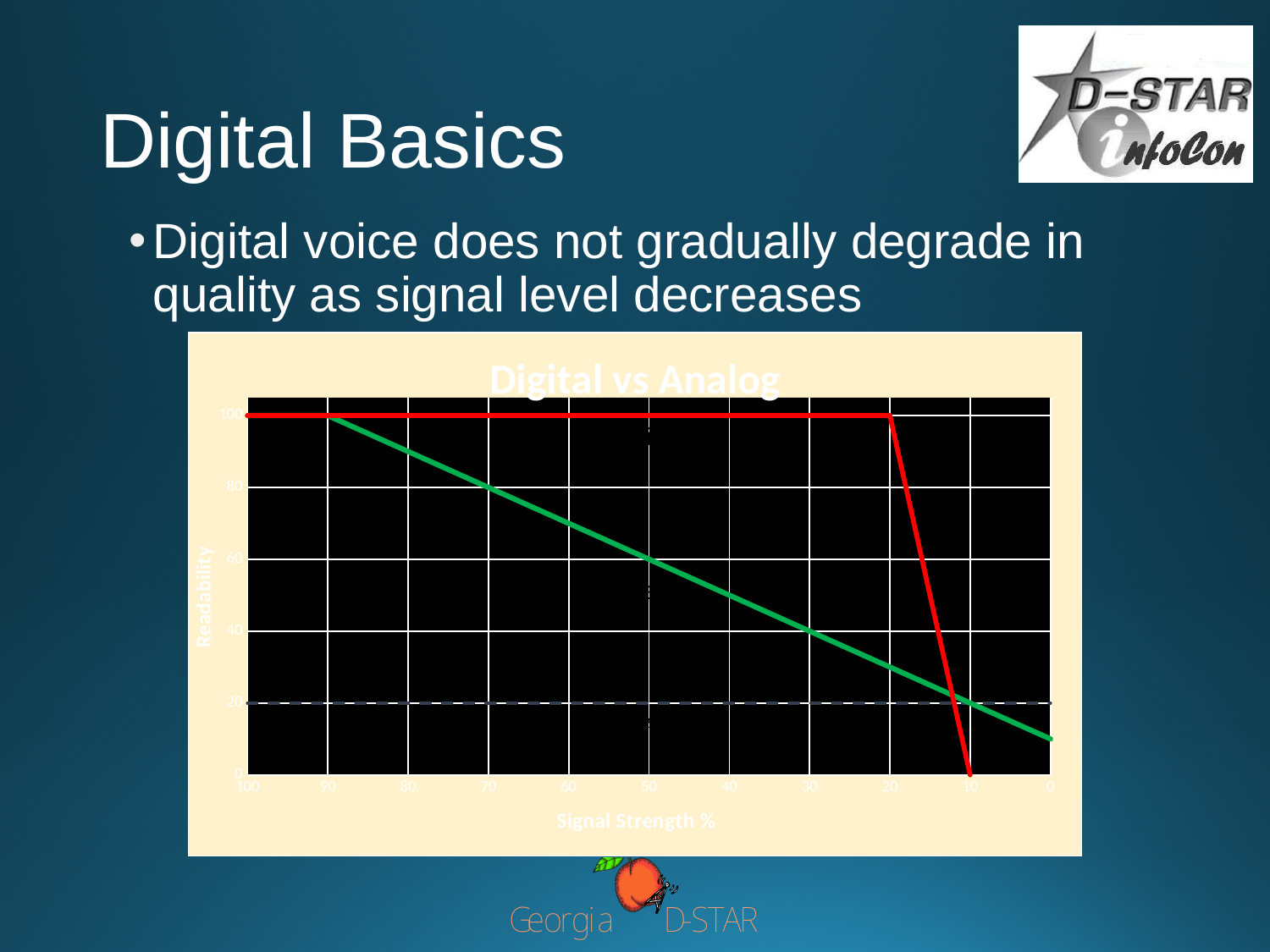
At a signal strength of 50%, which line has the higher readability, the red line or the green line? red line What is the title of the chart? Digital vs Analog What kind of chart is shown on the slide? line chart What is the readability value of the red line at a signal strength of 50%? 100 How many lines are plotted on the chart? 3 At a signal strength of 10%, which line has the higher readability, the red line or the green line? green line Is the readability of the green line at a signal strength of 30% greater or less than 20? greater Does the readability of the green line rise or fall as signal strength decreases from 100% to 0%? fall What is the label of the x axis of the chart? Signal Strength % Is the readability of the green line at a signal strength of 50% greater or less than 80? less Is the readability of the green line at a signal strength of 0% greater or less than 20? less What is the readability value of the red line at a signal strength of 10%? 0